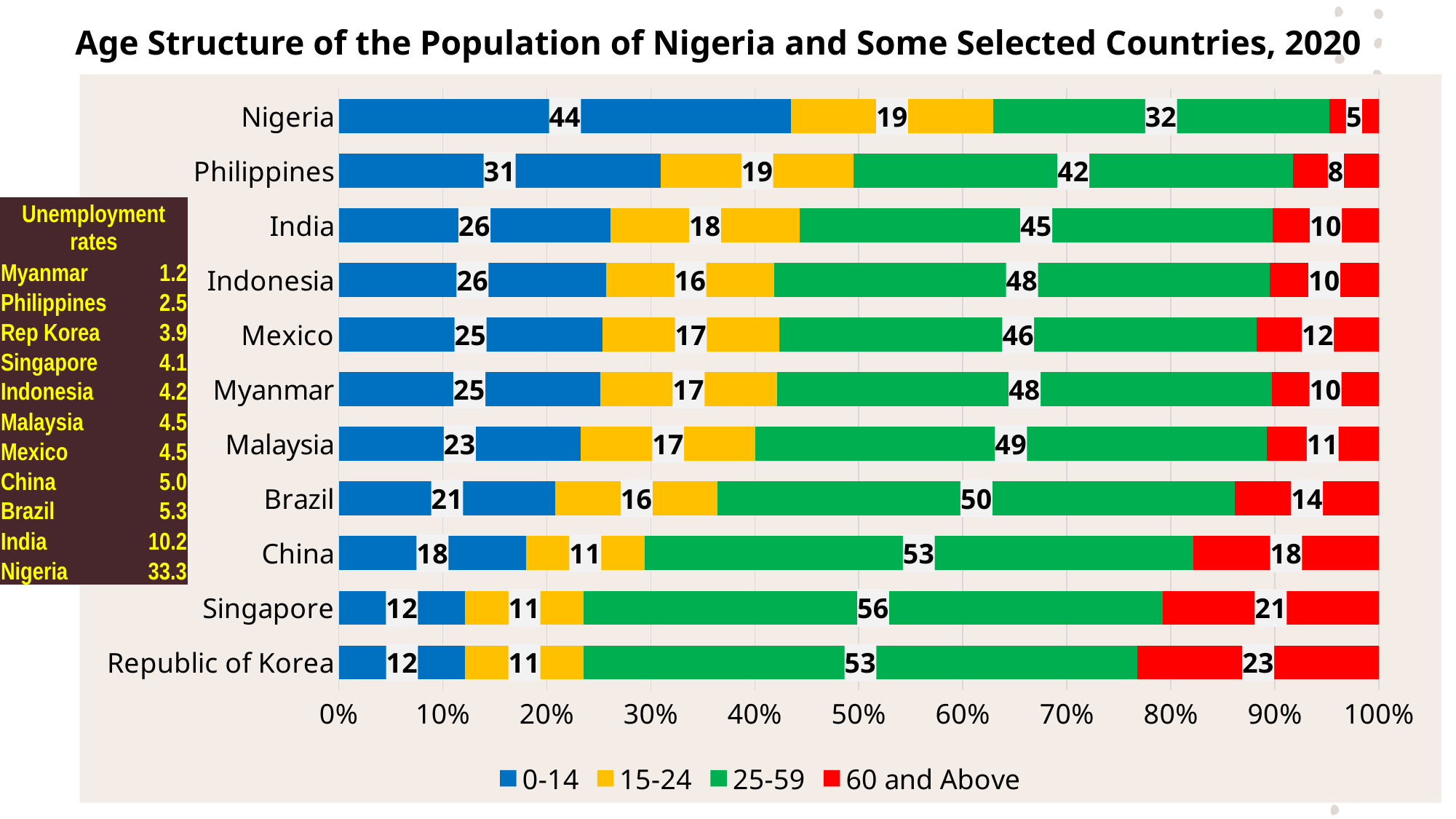
How many countries are shown on the chart? 11 What kind of chart is shown on the slide? Stacked bar chart Which country has the highest value for the 25-59 age group? Singapore What is the difference between the 0-14 values for Nigeria and Philippines? 13 Which country has the highest value for the 0-14 age group? Nigeria Which is larger: the 60 and Above value for China or for Brazil? China What is the total of the four segments for Mexico? 100 Which country has the lowest value for the 60 and Above age group? Nigeria What is the value of the 25-59 segment for Brazil? 50 How many series does the legend list? 4 What is the value of the 60 and Above segment for Republic of Korea? 23 What is the value of the 0-14 segment for Nigeria? 44